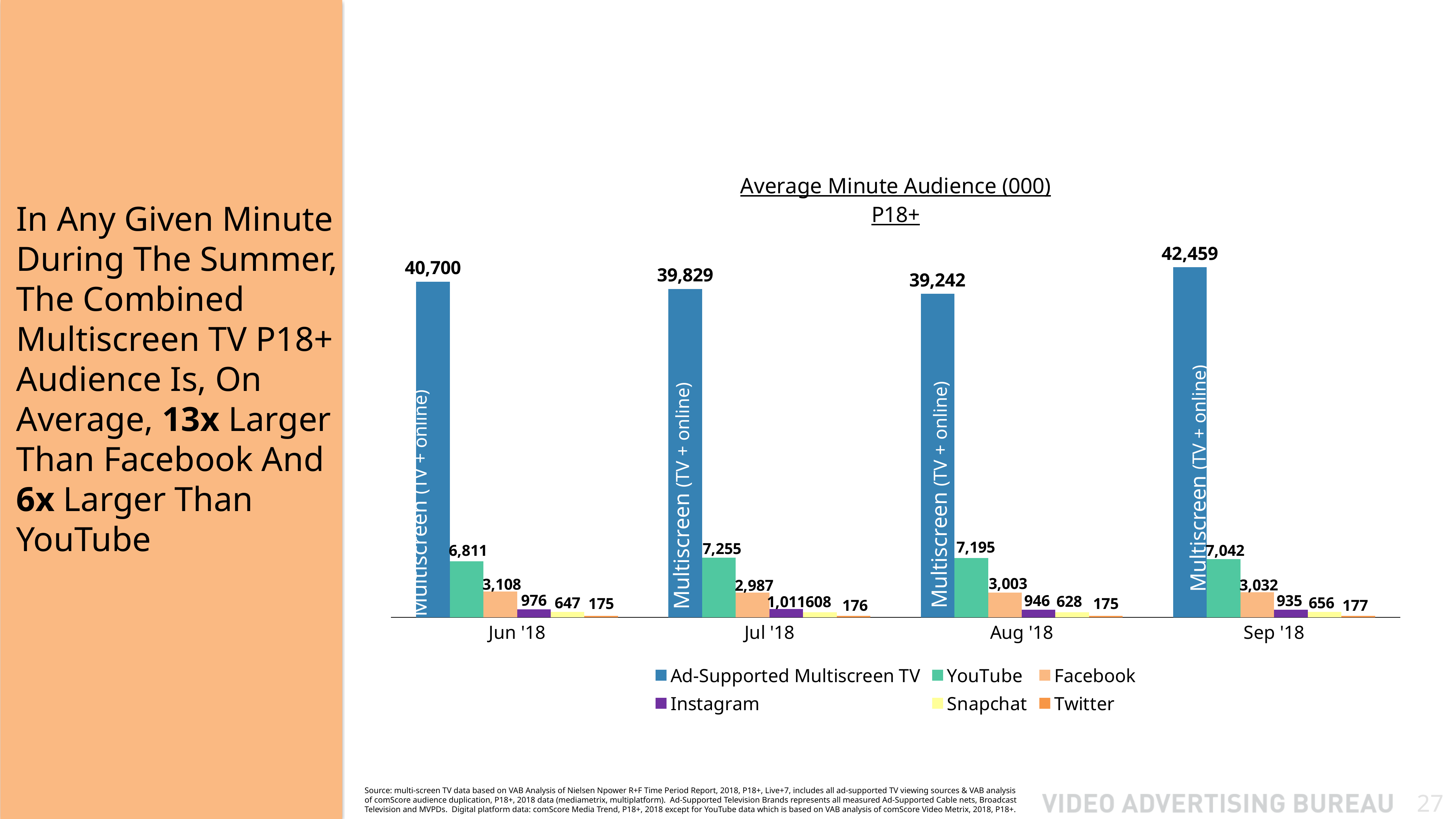
What is the Twitter value for Sep '18? 177 What is the Instagram value for Jul '18? 1,011 How many series does the legend list? 6 What kind of chart is shown on the slide? Bar chart What is the Facebook value for Jun '18? 3,108 Which is larger, the YouTube value for Jul '18 or for Aug '18? Jul '18 What is the difference between the Ad-Supported Multiscreen TV values for Sep '18 and Jun '18? 1,759 In which month is the Ad-Supported Multiscreen TV value highest? Sep '18 What is the YouTube value for Jul '18? 7,255 In which month is the Ad-Supported Multiscreen TV value lowest? Aug '18 What is the Ad-Supported Multiscreen TV value for Sep '18? 42,459 How many months are shown on the x axis? 4